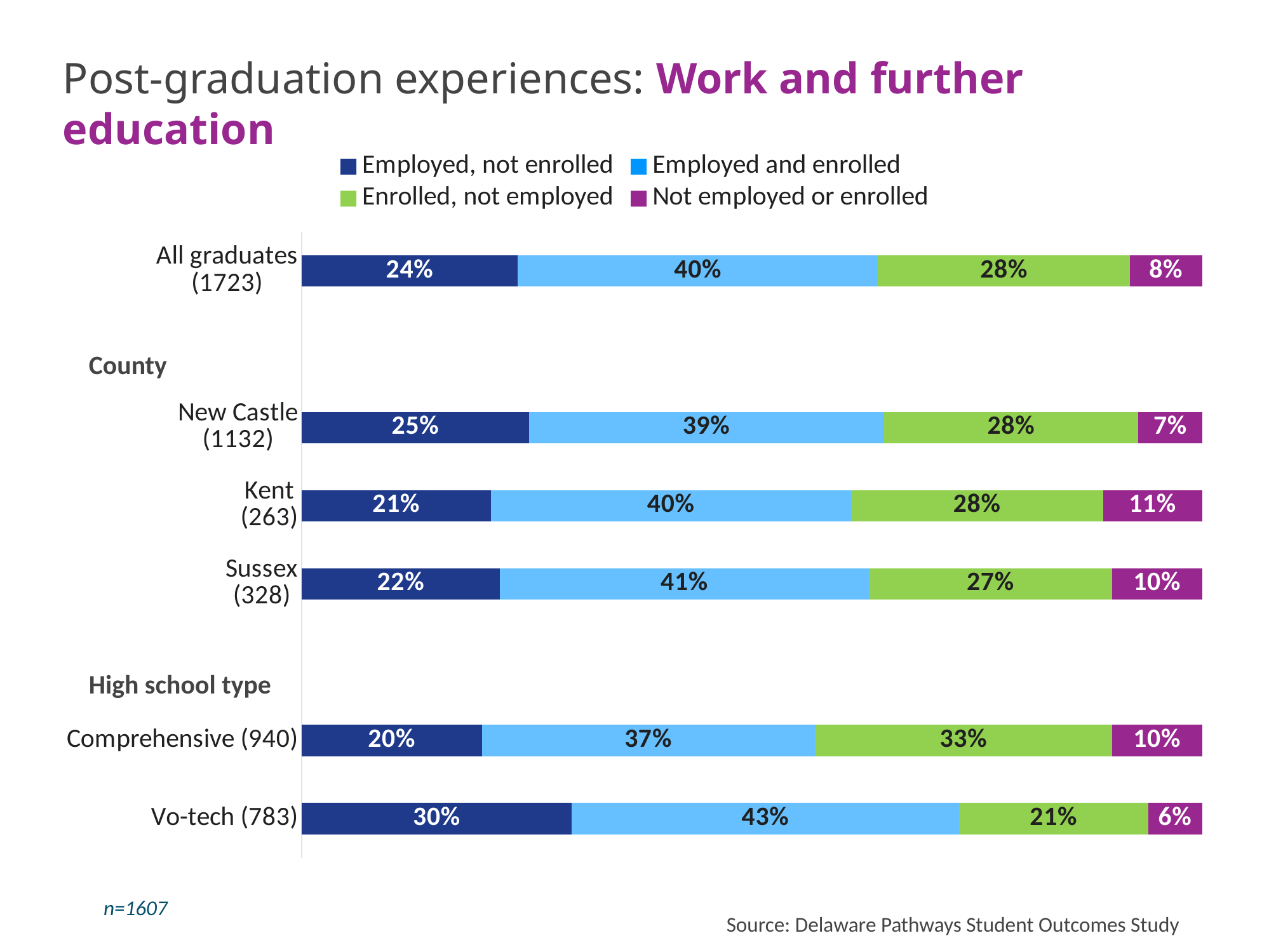
What is the Enrolled, not employed value for Comprehensive (940)? 33% How many series does the legend list? 4 What percentage of Vo-tech (783) graduates are Employed, not enrolled? 30% What is the total of the stacked bar for Sussex (328)? 100% What kind of chart is shown on the slide? Stacked bar chart Which category has the highest Employed, not enrolled value? Vo-tech (783) Which category has the lowest Not employed or enrolled value? Vo-tech (783) Which is larger: the Enrolled, not employed value for Comprehensive (940) or for Vo-tech (783)? Comprehensive (940) How many categories (bars) are shown in the chart? 6 What percentage of All graduates (1723) are Employed and enrolled? 40% What is the difference between the Employed, not enrolled values for Vo-tech (783) and Comprehensive (940)? 10% What is the Not employed or enrolled value for Kent (263)? 11%